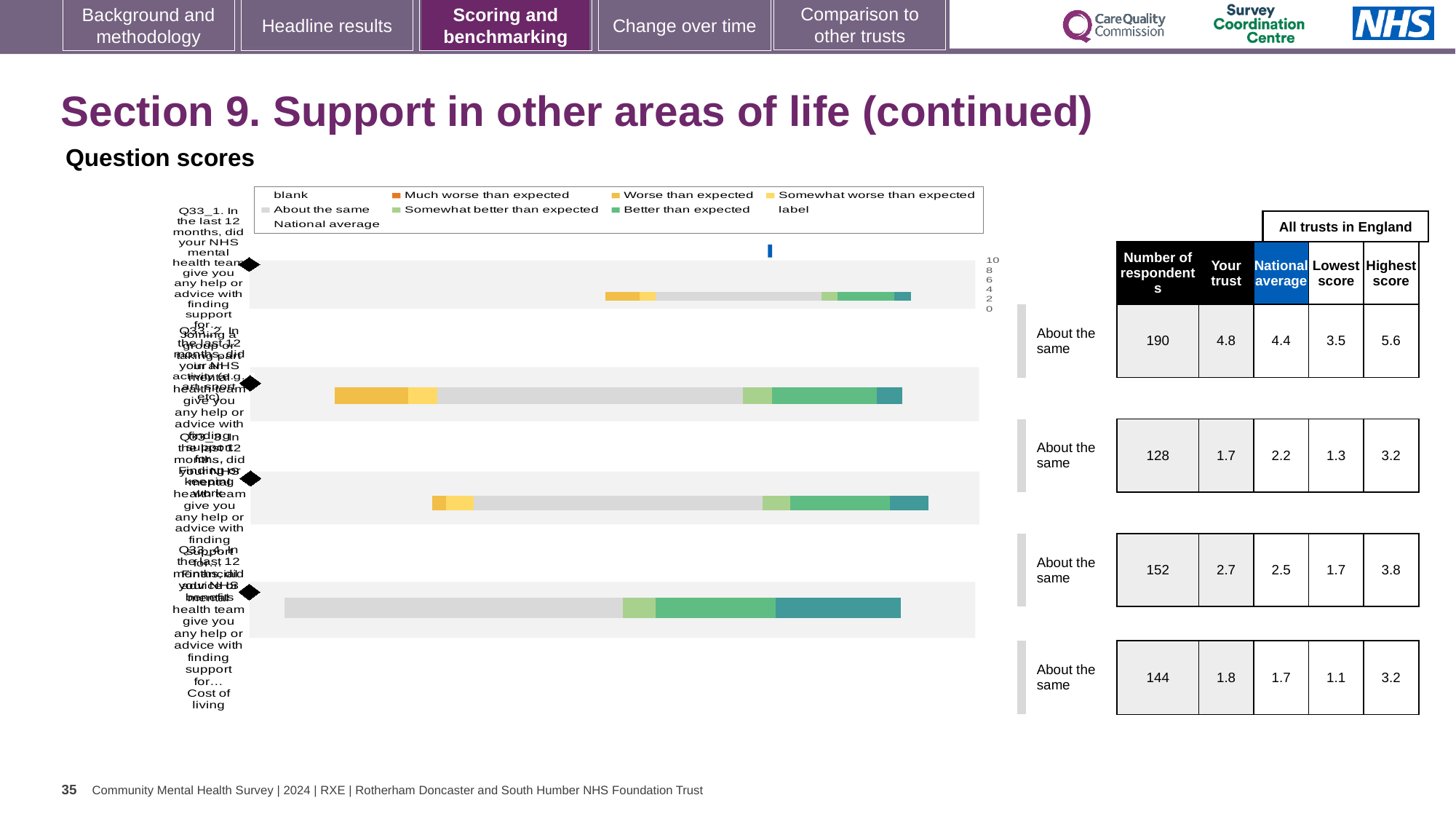
In the table beside the chart, what is the national average for Q33_2? 2.2 In the table beside the chart, what is the difference between the highest score and lowest score for Q33_4? 2.1 In the table beside the chart, which question has the highest number of respondents? Q33_1 In the table beside the chart, what is the number of respondents for Q33_1? 190 In the table beside the chart, is the 'Your trust' score for Q33_1 larger than its national average? Yes, 4.8 vs 4.4 Which legend entry is shown in grey in the chart? About the same In the table beside the chart, which question has the lowest 'Your trust' score? Q33_2 How many question bars (Q33_1 to Q33_4) are plotted in the chart? 4 How many entries does the chart's legend list? 9 Which legend entry is shown in orange in the chart? Much worse than expected What kind of chart is shown under 'Question scores'? Bar chart In the table beside the chart, what is the 'Your trust' score for Q33_3? 2.7